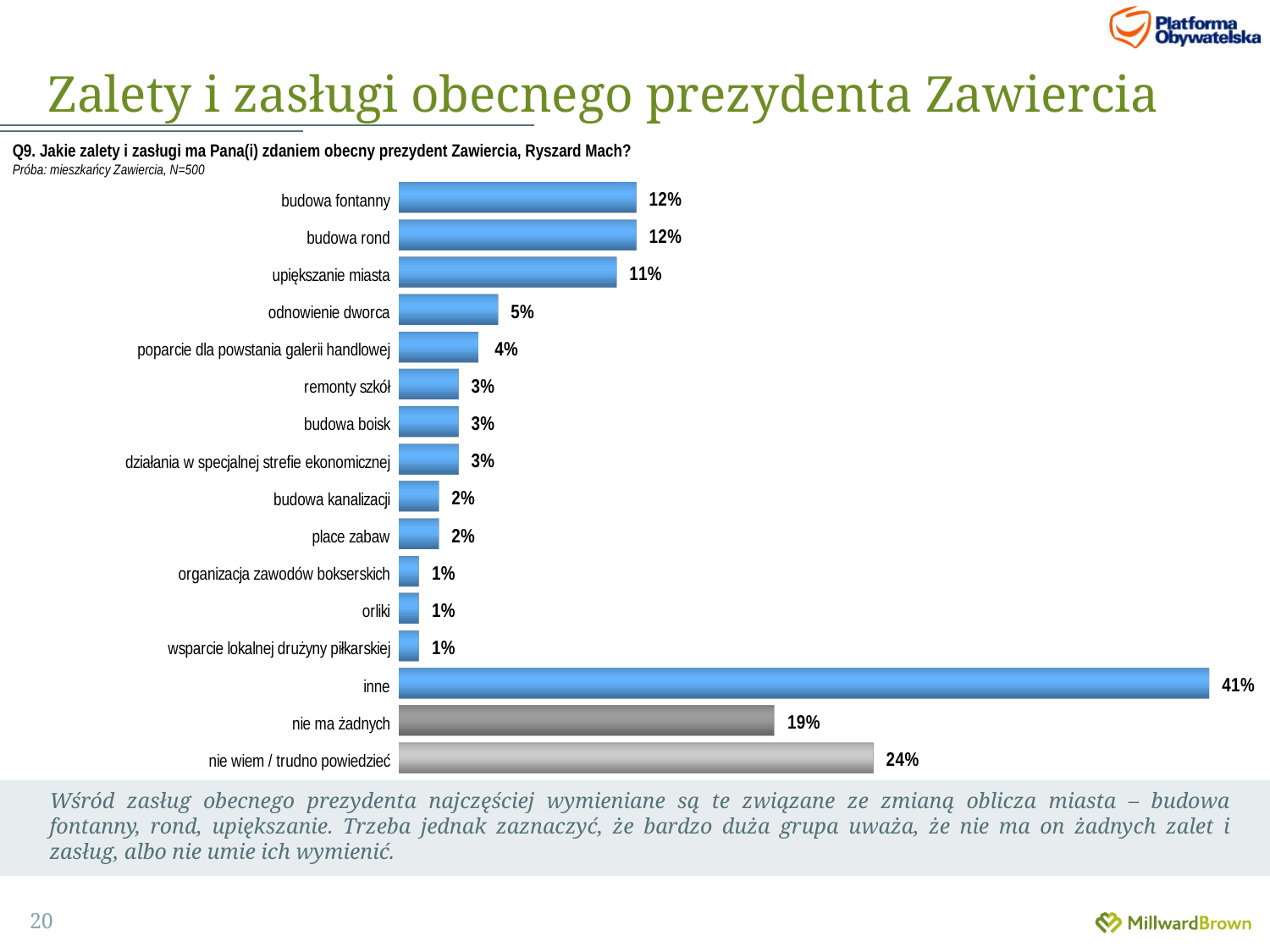
What is the value for 'upiększanie miasta'? 11% What is the value for 'budowa fontanny'? 12% What is the value for 'nie ma żadnych'? 19% What is the difference between 'budowa rond' and 'odnowienie dworca'? 7% What is the value for 'budowa kanalizacji'? 2% How many categories are shown in the chart? 16 What is the difference between 'inne' and 'nie wiem / trudno powiedzieć'? 17% What is the value for 'nie wiem / trudno powiedzieć'? 24% Which category has the highest value? inne Which is larger, 'odnowienie dworca' or 'poparcie dla powstania galerii handlowej'? odnowienie dworca What kind of chart is shown on the slide? bar chart Which is larger, 'nie ma żadnych' or 'nie wiem / trudno powiedzieć'? nie wiem / trudno powiedzieć